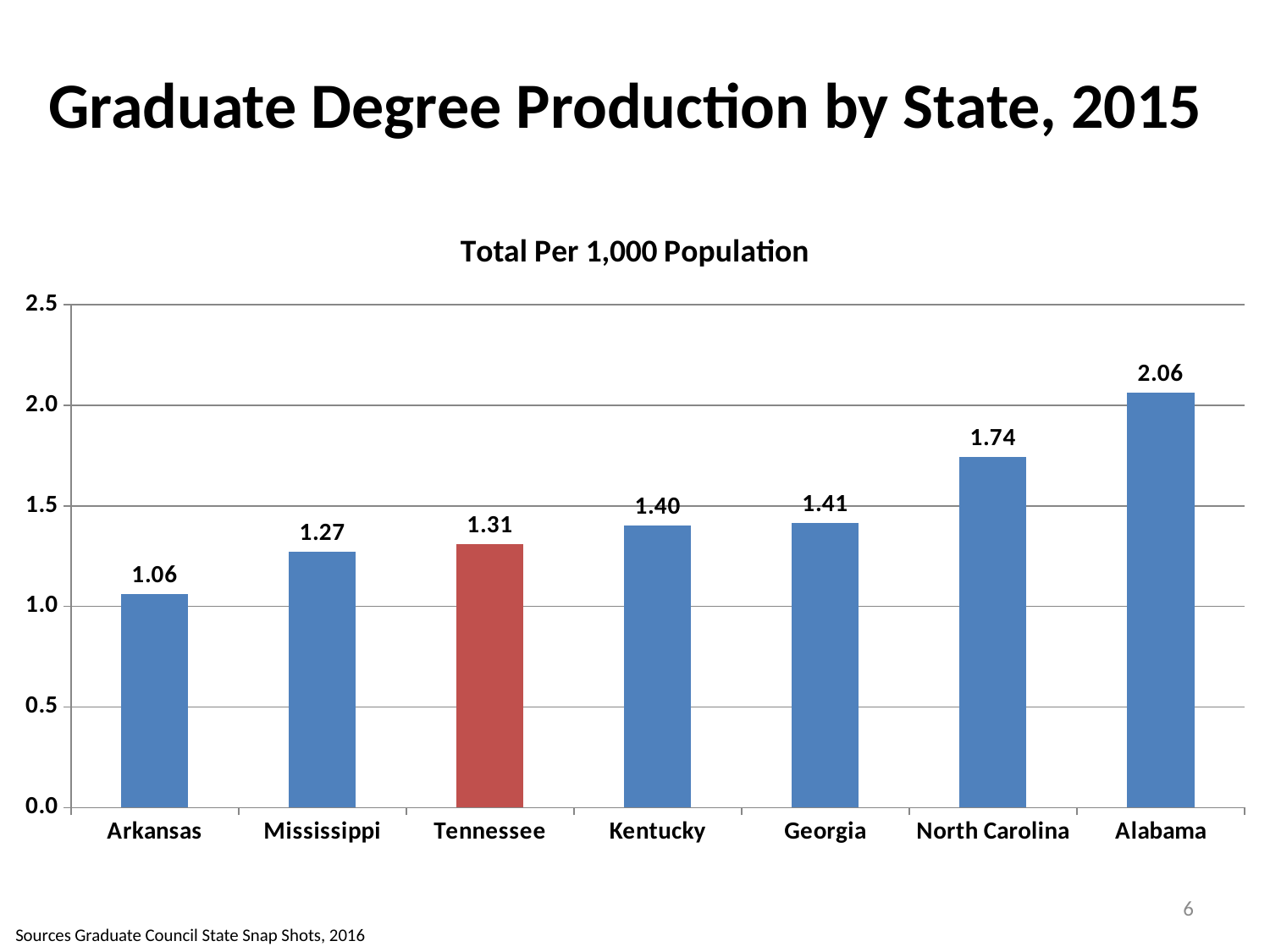
What kind of chart is shown on the slide? bar chart What is the difference between the values for Alabama and Arkansas? 1.00 What is the value for Arkansas? 1.06 Which state's bar is coloured red instead of blue? Tennessee What is the value for North Carolina? 1.74 How many states are shown in the chart? 7 Which state has the lowest value? Arkansas What is the difference between the values for North Carolina and Tennessee? 0.43 Is the value for Alabama greater or less than 2.0? greater What is the value for Tennessee? 1.31 Which state has the highest value? Alabama Which is larger, the value for Mississippi or the value for Kentucky? Kentucky